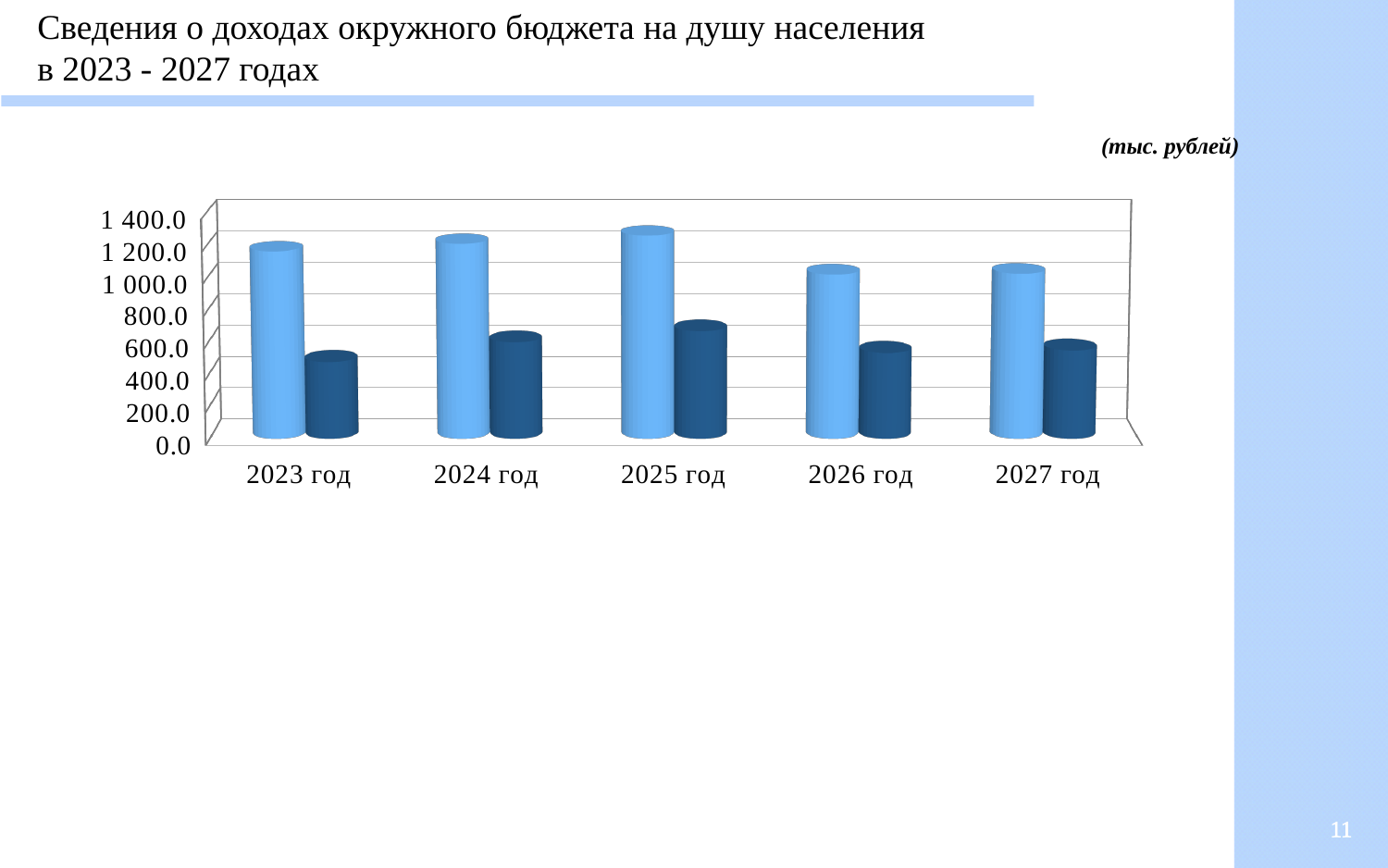
In which year is the dark blue bar the tallest? 2025 год In which year is the dark blue bar the shortest? 2023 год Is the value of the light blue bar for 2025 год greater or less than 1 200.0? greater Do the light blue bars rise or fall from 2023 год to 2025 год? rise How many bars are plotted for each year in the chart? 2 In which year is the light blue bar the tallest? 2025 год Is the value of the light blue bar for 2026 год greater or less than 1 200.0? less Which is larger: the light blue bar for 2024 год or the light blue bar for 2026 год? 2024 год What kind of chart is shown on the slide? Bar chart How many years (categories) are shown on the x axis of the chart? 5 Is the value of the dark blue bar for 2023 год greater or less than 600.0? less In what units are the values of the chart given, according to the note above the chart? тыс. рублей